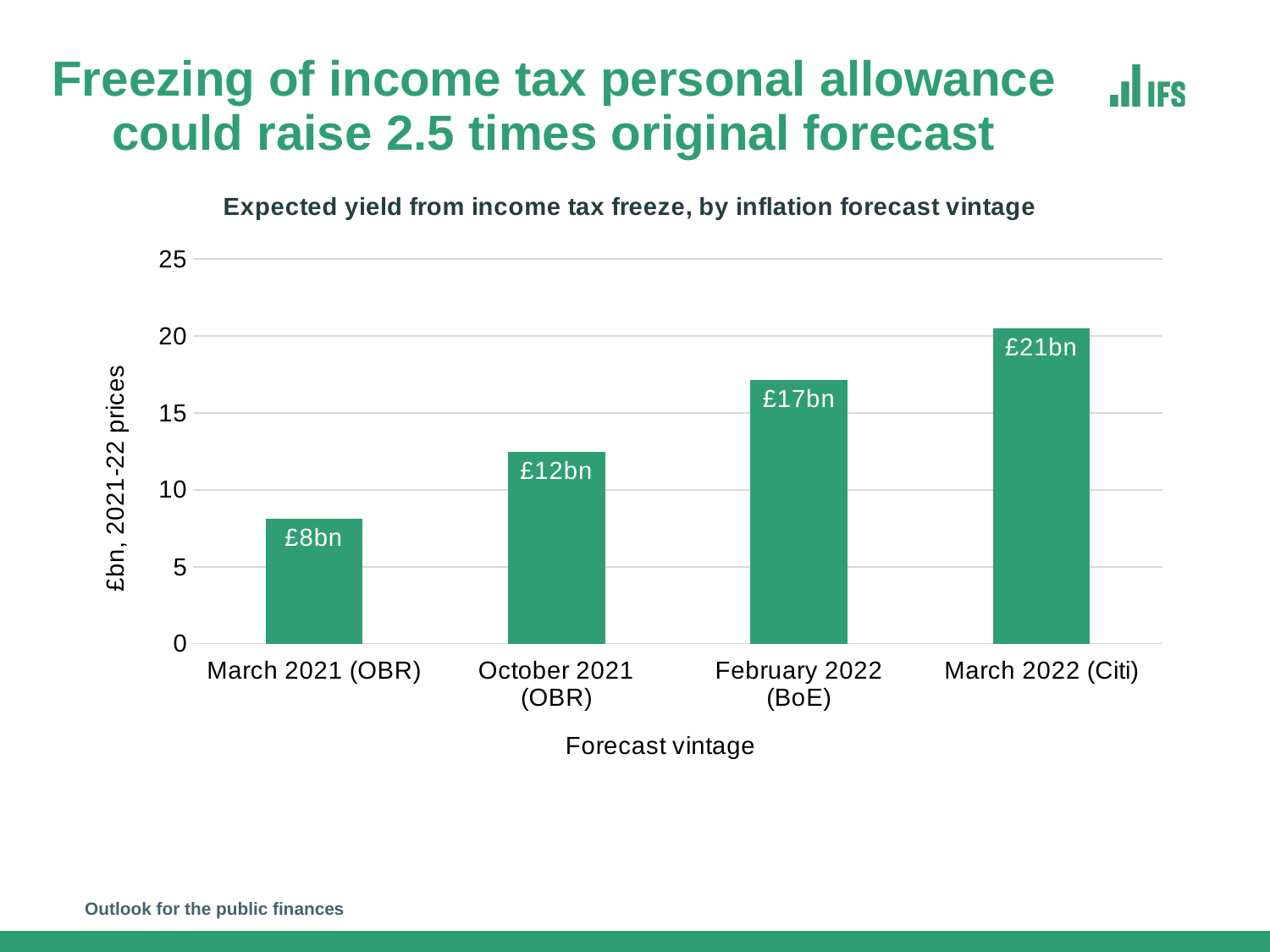
Which forecast vintage has the lowest expected yield? March 2021 (OBR) Which has a larger expected yield, October 2021 (OBR) or February 2022 (BoE)? February 2022 (BoE) What is the expected yield for the October 2021 (OBR) forecast vintage? £12bn What is the difference in expected yield between the March 2022 (Citi) and March 2021 (OBR) forecast vintages? £13bn What is the expected yield for the March 2022 (Citi) forecast vintage? £21bn What is the expected yield for the March 2021 (OBR) forecast vintage? £8bn What kind of chart is shown on the slide? Bar chart How many forecast vintages are shown on the chart? 4 Do the expected yields rise or fall across the forecast vintages from left to right? Rise Which forecast vintage has the highest expected yield? March 2022 (Citi) What is the expected yield for the February 2022 (BoE) forecast vintage? £17bn Is the value for February 2022 (BoE) greater or less than 15? greater